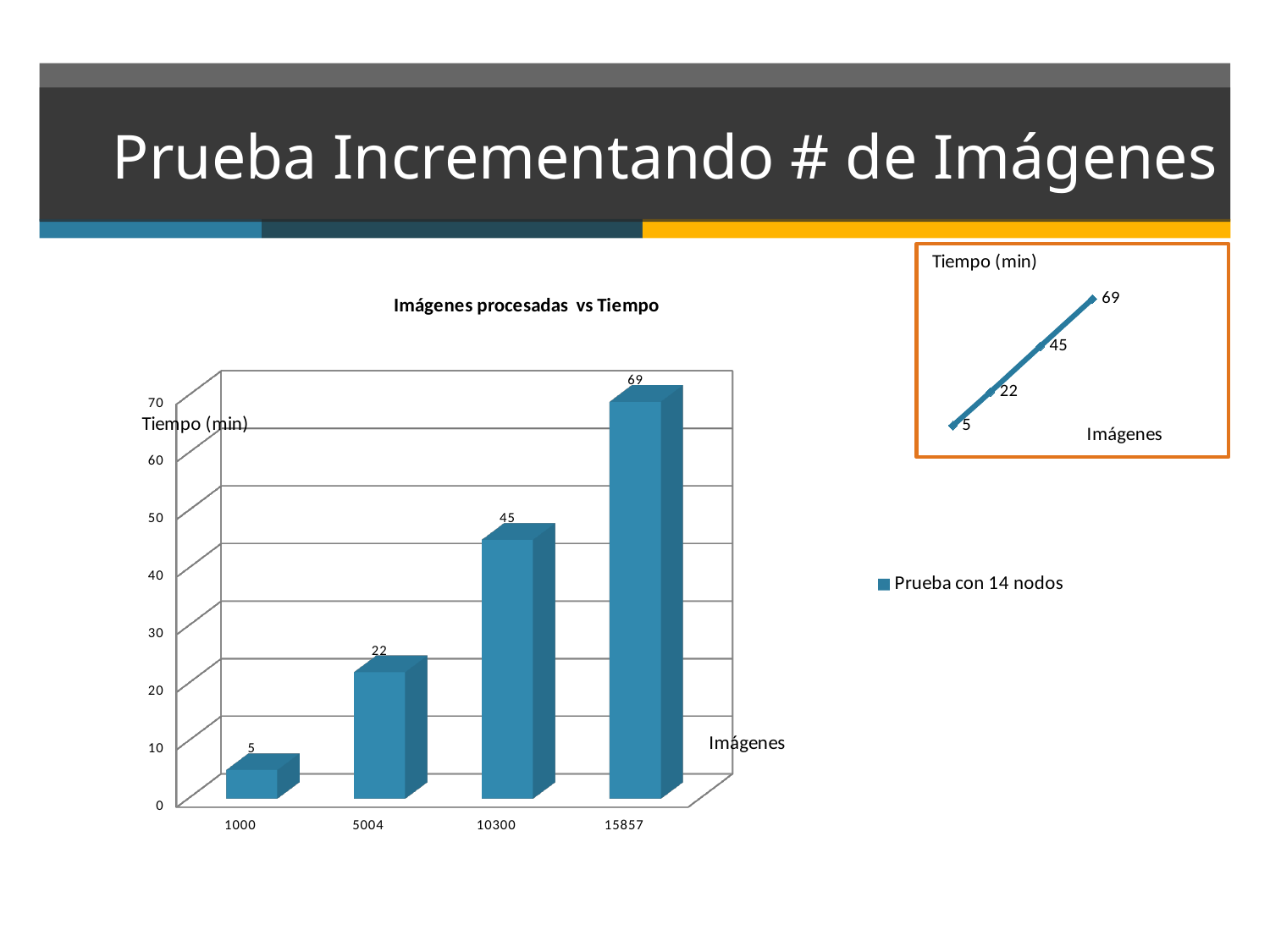
In the bar chart 'Imágenes procesadas vs Tiempo', how many categories are shown on the x axis? 4 In the bar chart 'Imágenes procesadas vs Tiempo', what series name does the legend list? Prueba con 14 nodos In the bar chart 'Imágenes procesadas vs Tiempo', which is larger: the time for 5004 images or the time for 10300 images? 10300 In the bar chart 'Imágenes procesadas vs Tiempo', what is the time value for 5004 images? 22 In the bar chart 'Imágenes procesadas vs Tiempo', what is the time value for 15857 images? 69 In the bar chart 'Imágenes procesadas vs Tiempo', do the values rise or fall as the number of images increases along the x axis? rise What kind of chart is the chart titled 'Imágenes procesadas vs Tiempo'? bar chart In the small line chart at the top right of the slide, what is the highest labelled value? 69 In the bar chart 'Imágenes procesadas vs Tiempo', what is the difference between the time for 15857 images and the time for 10300 images? 24 In the bar chart 'Imágenes procesadas vs Tiempo', which category has the lowest time value? 1000 In the bar chart 'Imágenes procesadas vs Tiempo', what is the time value for 1000 images? 5 In the bar chart 'Imágenes procesadas vs Tiempo', which category has the highest time value? 15857